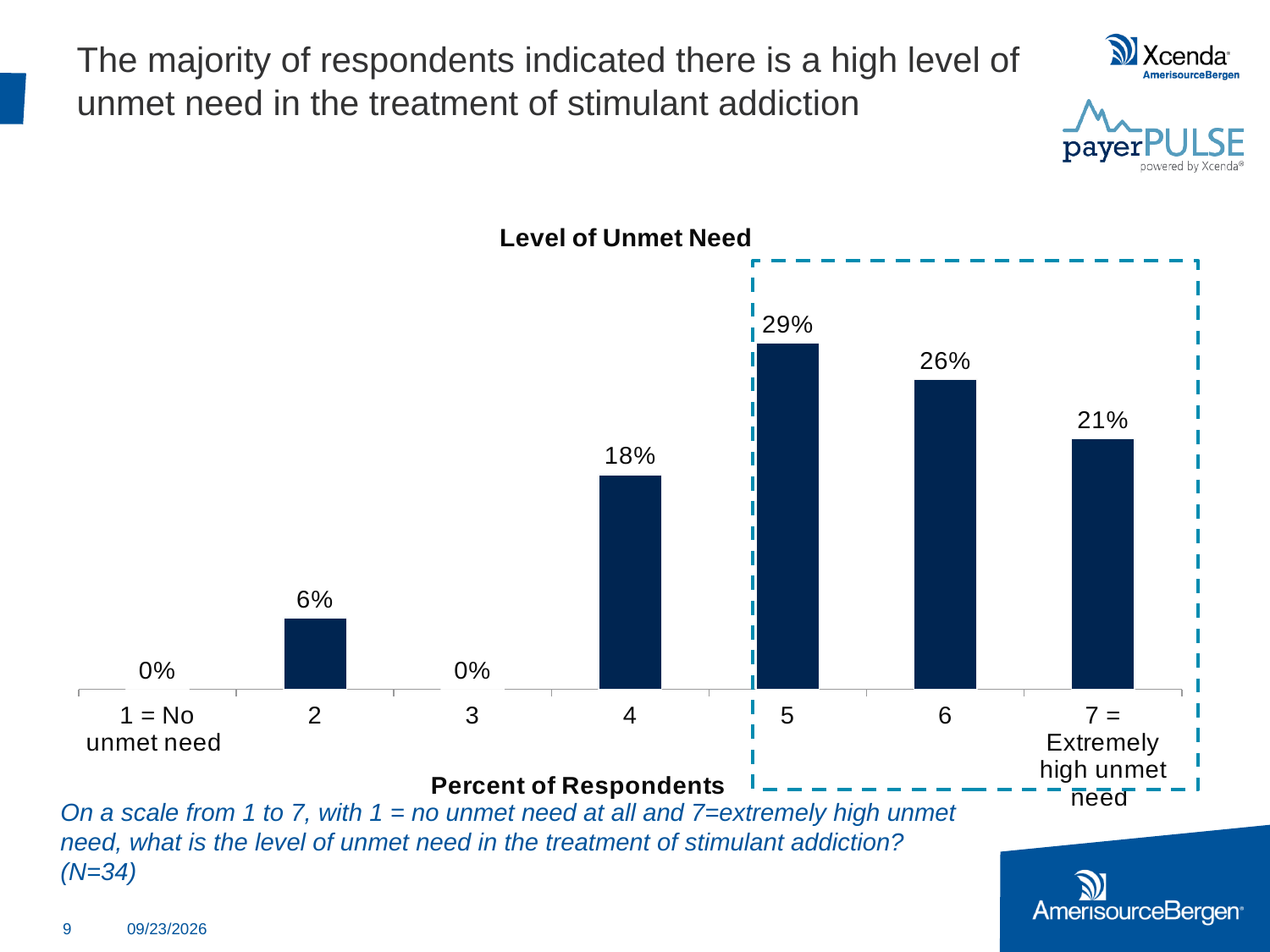
Which rating on the scale has the highest percent of respondents? 5 What is the combined percent of respondents for ratings 5, 6 and 7? 76% What percent of respondents rated the level of unmet need as 2? 6% What is the title of the chart? Level of Unmet Need What percent of respondents rated the level of unmet need as 7 = Extremely high unmet need? 21% Which ratings have 0% of respondents? 1 and 3 How many rating categories are shown on the x axis? 7 What percent of respondents rated the level of unmet need as 5? 29% What kind of chart is shown on the slide? Bar chart What is the difference in percent of respondents between rating 5 and rating 6? 3% Which has a larger percent of respondents, rating 4 or rating 7? 7 What is the difference in percent of respondents between rating 4 and rating 2? 12%